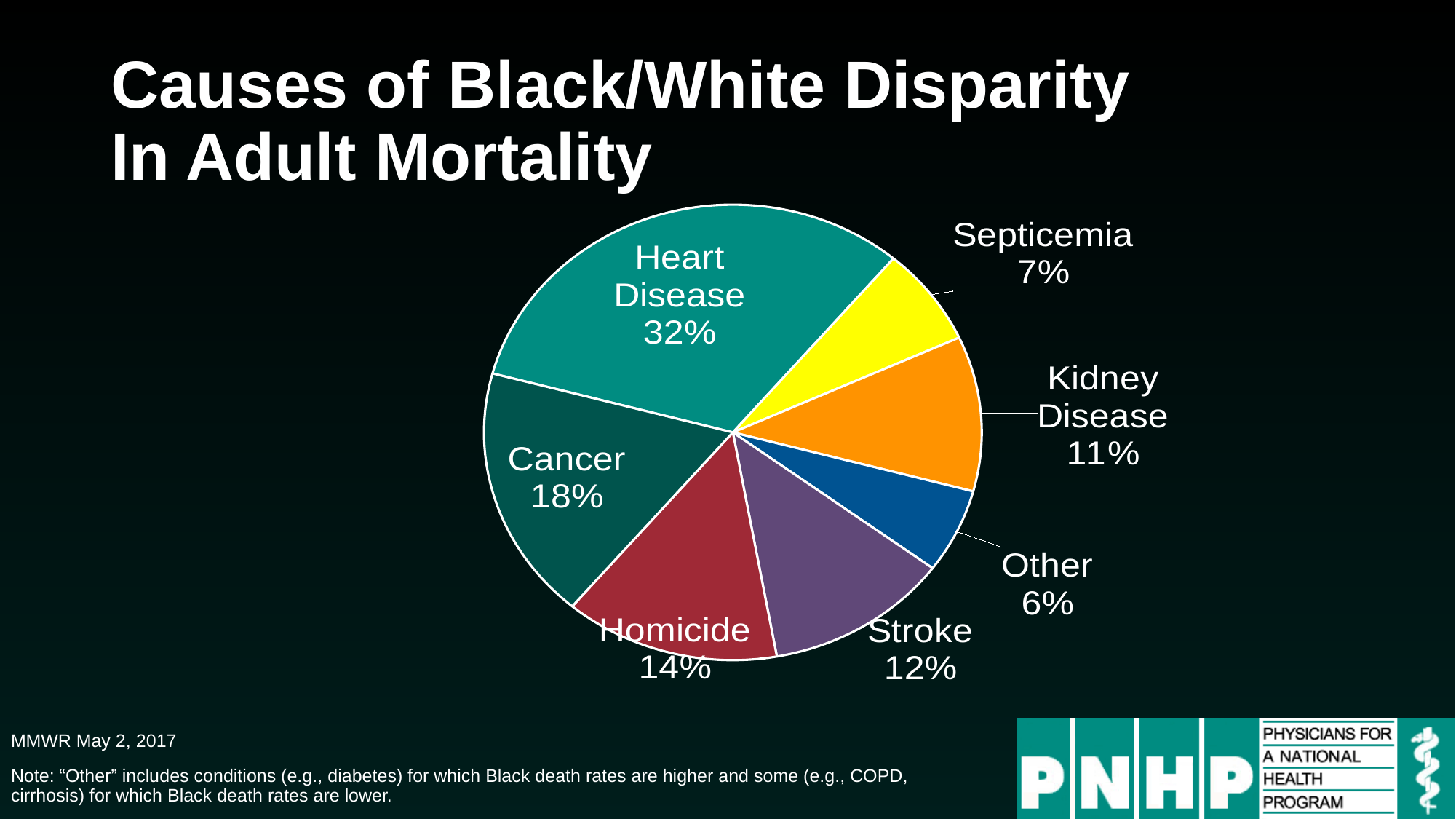
Which category has the largest slice of the pie? Heart Disease What is the value shown for Cancer? 18% What is the value shown for Kidney Disease? 11% Which is larger, the Stroke slice or the Septicemia slice? Stroke What is the value shown for Homicide? 14% What is the difference between the Heart Disease and Cancer percentages? 14% What kind of chart is shown on the slide? pie chart How many slices does the pie chart have? 7 What share of the pie does Heart Disease account for? 32% What is the title of the chart on the slide? Causes of Black/White Disparity In Adult Mortality What is the difference between the Stroke and Kidney Disease percentages? 1% Which category has the smallest slice of the pie? Other